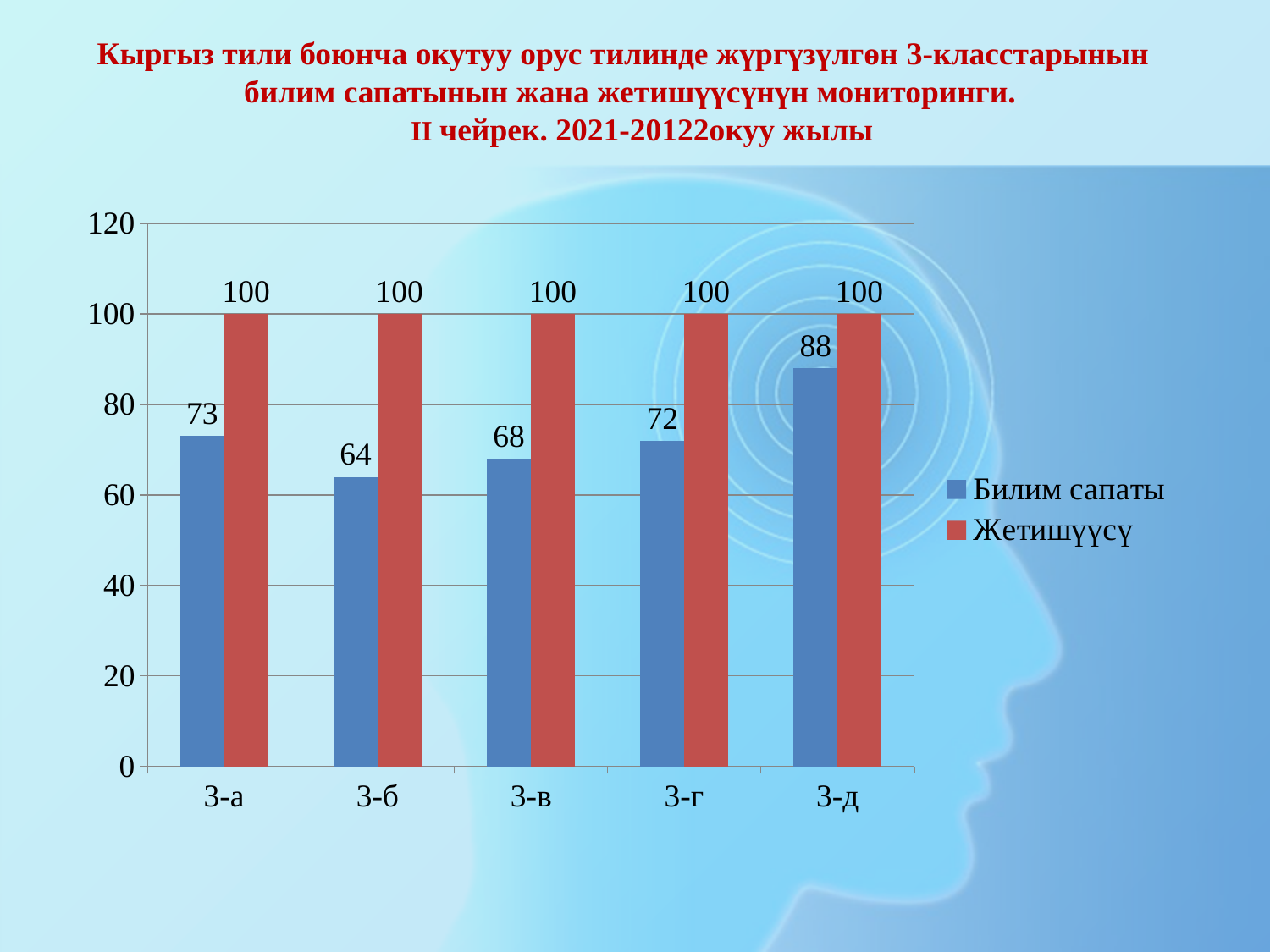
Which is larger, the Билим сапаты value for 3-а or for 3-г? 3-а What kind of chart is shown on the slide? bar chart How many classes are shown on the x axis? 5 Is the Билим сапаты value for 3-в greater or less than 80? less Which colour represents Жетишүүсү in the chart? red Which class has the highest Билим сапаты value? 3-д What is the value of Билим сапаты for 3-д? 88 What is the value of Жетишүүсү for 3-в? 100 What is the difference between the Билим сапаты values for 3-д and 3-б? 24 What is the value of Билим сапаты for 3-а? 73 Which class has the lowest Билим сапаты value? 3-б How many series does the legend list? 2